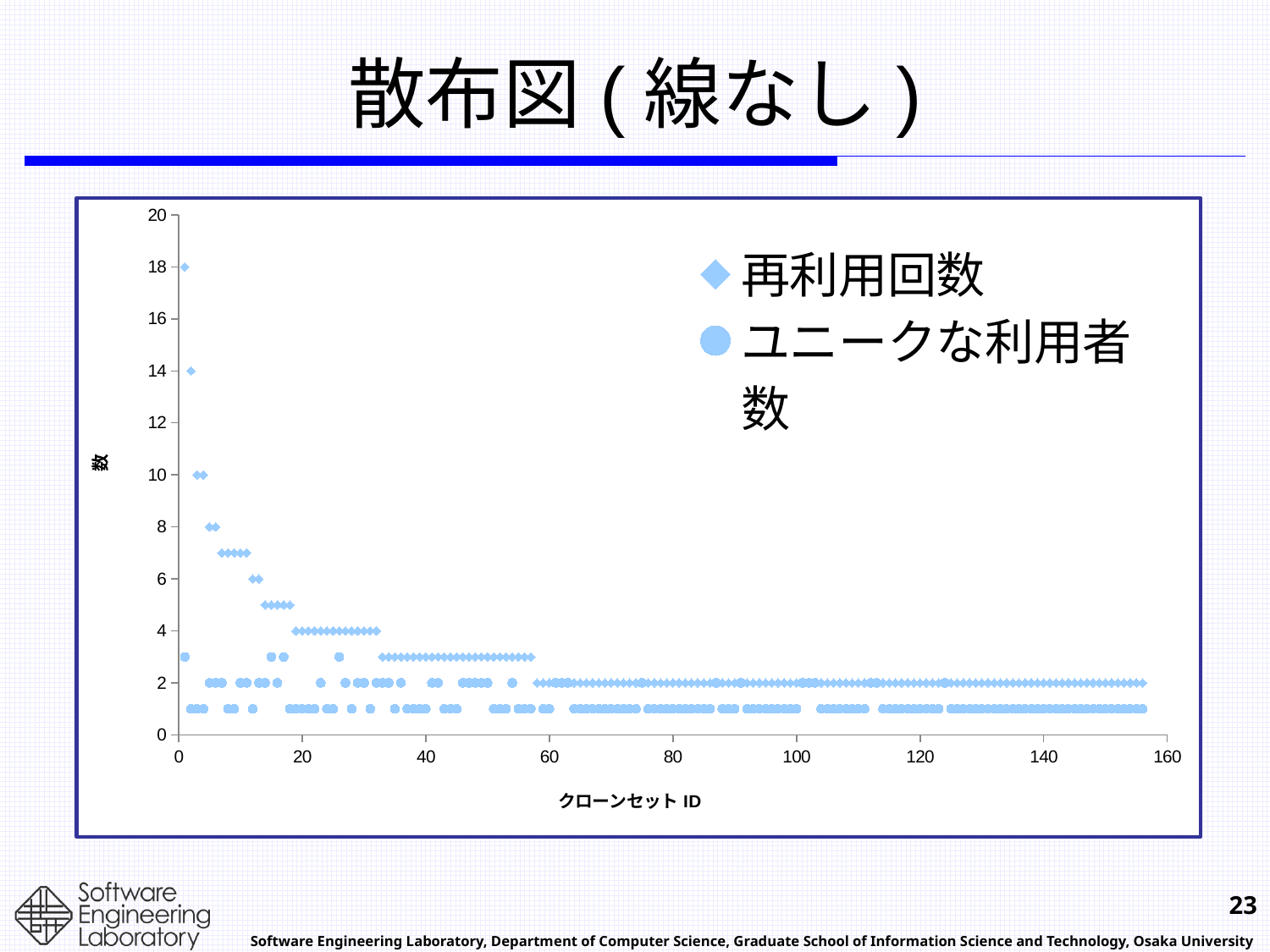
For the first クローンセット ID, which series has the higher value, 再利用回数 or ユニークな利用者数? 再利用回数 Is the value of 再利用回数 at クローンセット ID 100 greater or less than 4? less What is the lowest value plotted for 再利用回数? 2 What are the two series named in the legend? 再利用回数 and ユニークな利用者数 Do the 再利用回数 values rise or fall as クローンセット ID increases? fall What is the value of 再利用回数 for the first クローンセット ID? 18 What kind of chart is shown on the slide? scatter chart How many series does the legend list? 2 Is the highest value of ユニークな利用者数 greater or less than 4? less What is the title of the x axis? クローンセット ID What is the highest value plotted for 再利用回数? 18 Is the value of 再利用回数 at クローンセット ID 20 greater or less than 10? less